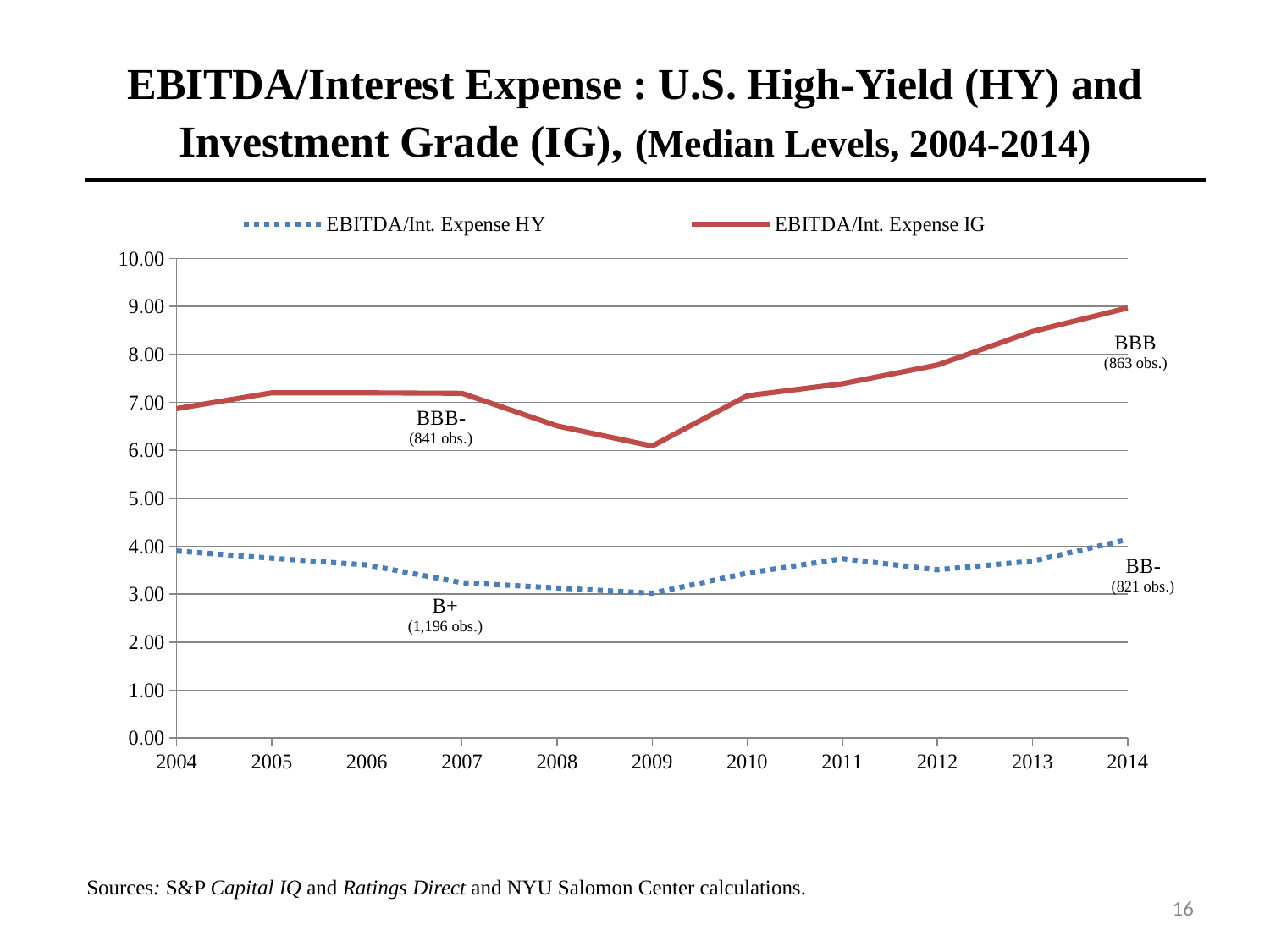
In which year is the EBITDA/Int. Expense HY series at its lowest? 2009 Is the value for EBITDA/Int. Expense HY in 2009 greater or less than 4.00? less What kind of chart is shown on the slide? line chart Is the value for EBITDA/Int. Expense IG in 2009 greater or less than 7.00? less How many years are shown on the x axis? 11 In which year is the EBITDA/Int. Expense IG series at its highest? 2014 Does the EBITDA/Int. Expense IG series rise or fall from 2009 to 2014? rise How many series does the legend list? 2 Which series has the higher value in 2011, EBITDA/Int. Expense HY or EBITDA/Int. Expense IG? EBITDA/Int. Expense IG In which year is the EBITDA/Int. Expense IG series at its lowest? 2009 What rating label and number of observations are annotated next to the IG line at 2014? BBB (863 obs.) Is the value for EBITDA/Int. Expense IG in 2014 greater or less than 8.00? greater